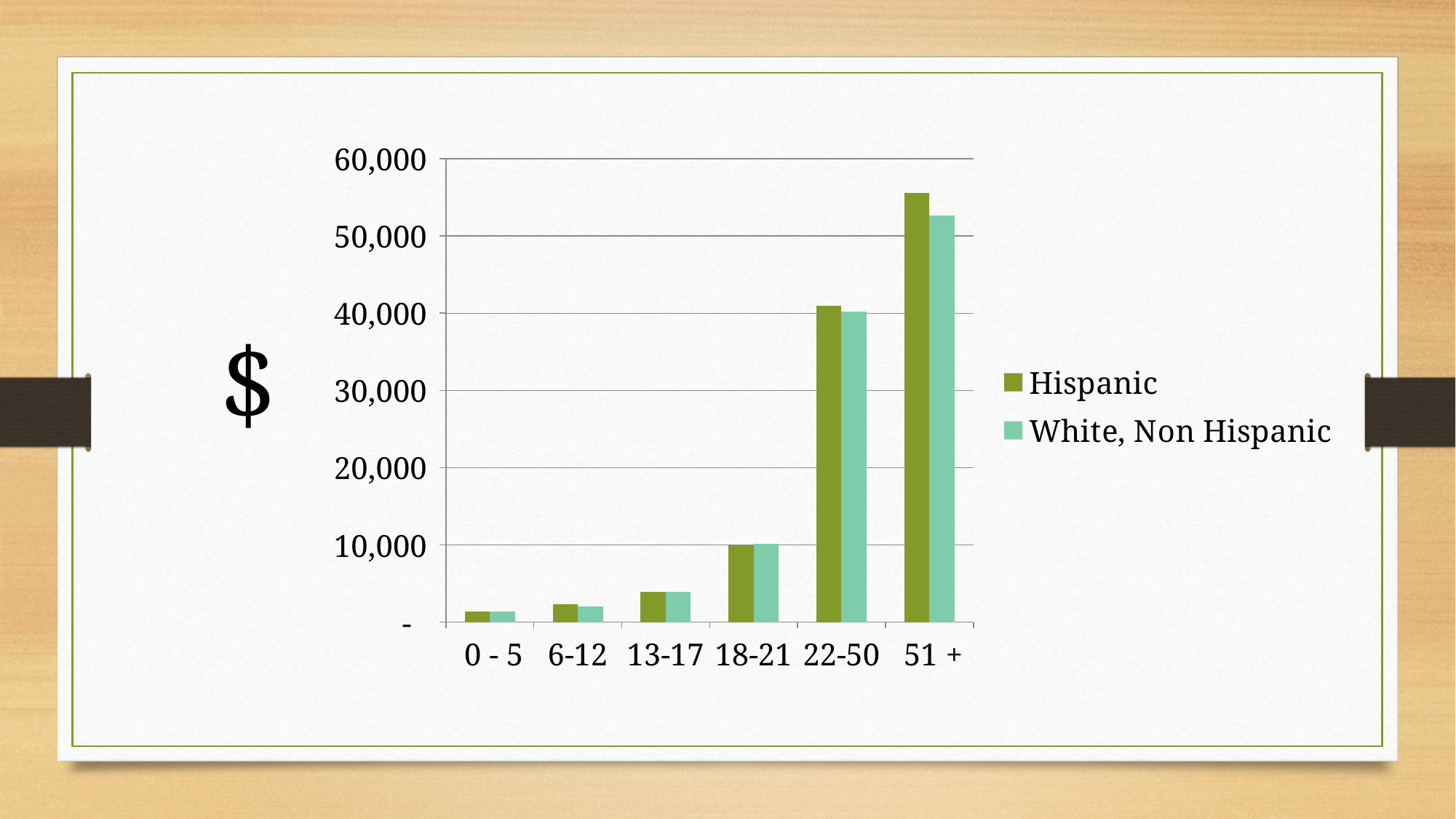
Is the Hispanic value for the 13-17 category greater or less than 10,000? less In the 51 + category, which series has the larger value, Hispanic or White, Non Hispanic? Hispanic How many series does the legend list? 2 Is the White, Non Hispanic value for the 22-50 category greater or less than 30,000? greater Which age category has the highest value for the Hispanic series? 51 + Is the Hispanic value for the 51 + category greater or less than 50,000? greater Which age category has the lowest value for the White, Non Hispanic series? 0 - 5 What kind of chart is shown on the slide? bar chart Do the values for the Hispanic series rise or fall as the age categories move from 0 - 5 to 51 +? rise How many age categories are shown on the x axis? 6 What label is shown on the vertical axis of the chart? $